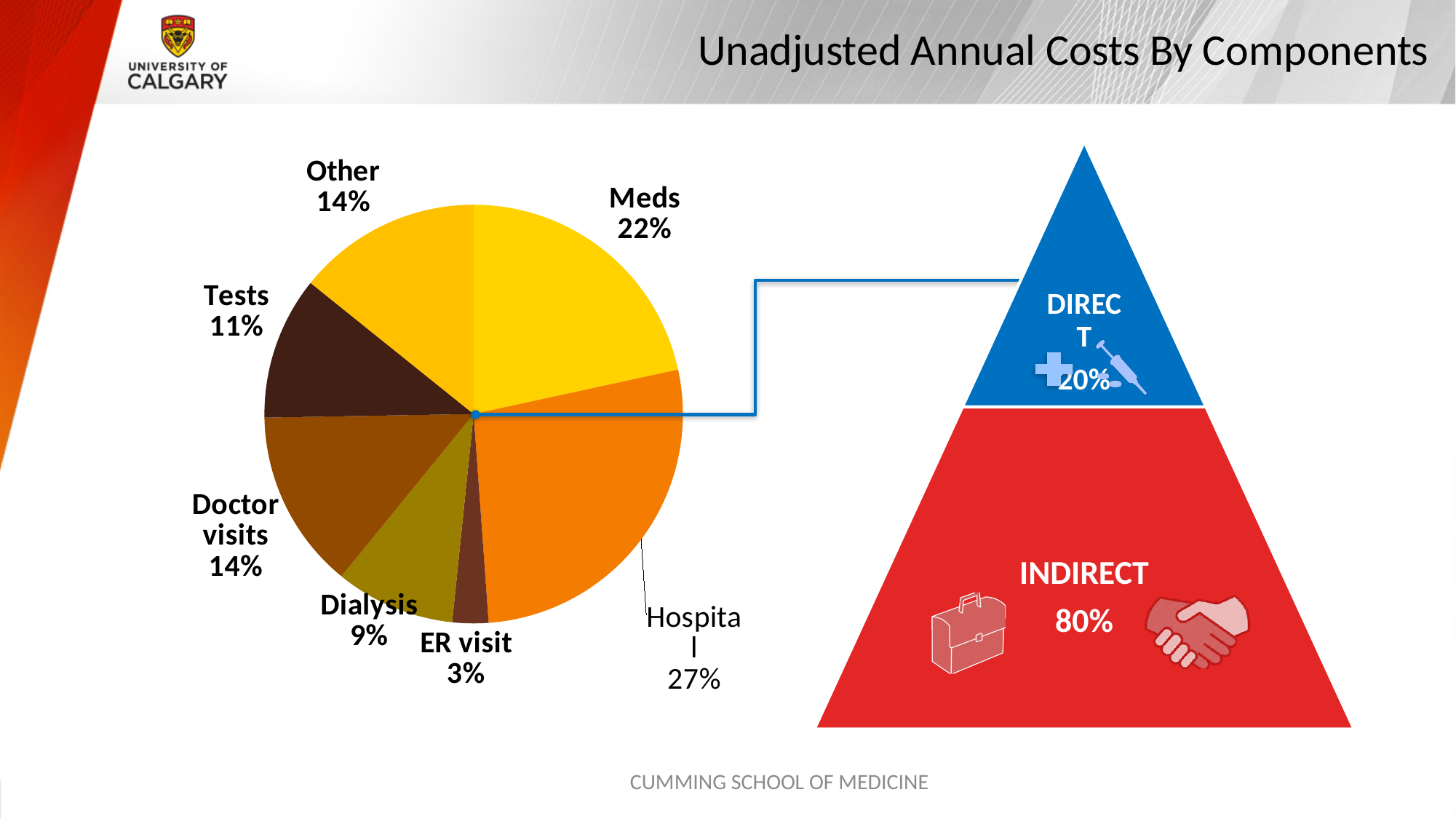
Which component has the largest slice of the pie chart? Hospital Which component has the smallest slice of the pie chart? ER visit What share of the pie chart does Hospital account for? 27% What percentage is shown for Meds in the pie chart? 22% Which is larger in the pie chart, Tests or Dialysis? Tests What is the title of the slide containing the pie chart? Unadjusted Annual Costs By Components Which is larger in the pie chart, Meds or Other? Meds What is the difference in percentage points between Doctor visits and Tests in the pie chart? 3 What type of chart is used to show the annual cost components? Pie chart How many slices does the pie chart have? 7 What is the difference in percentage points between Hospital and Meds in the pie chart? 5 What percentage is shown for Dialysis in the pie chart? 9%